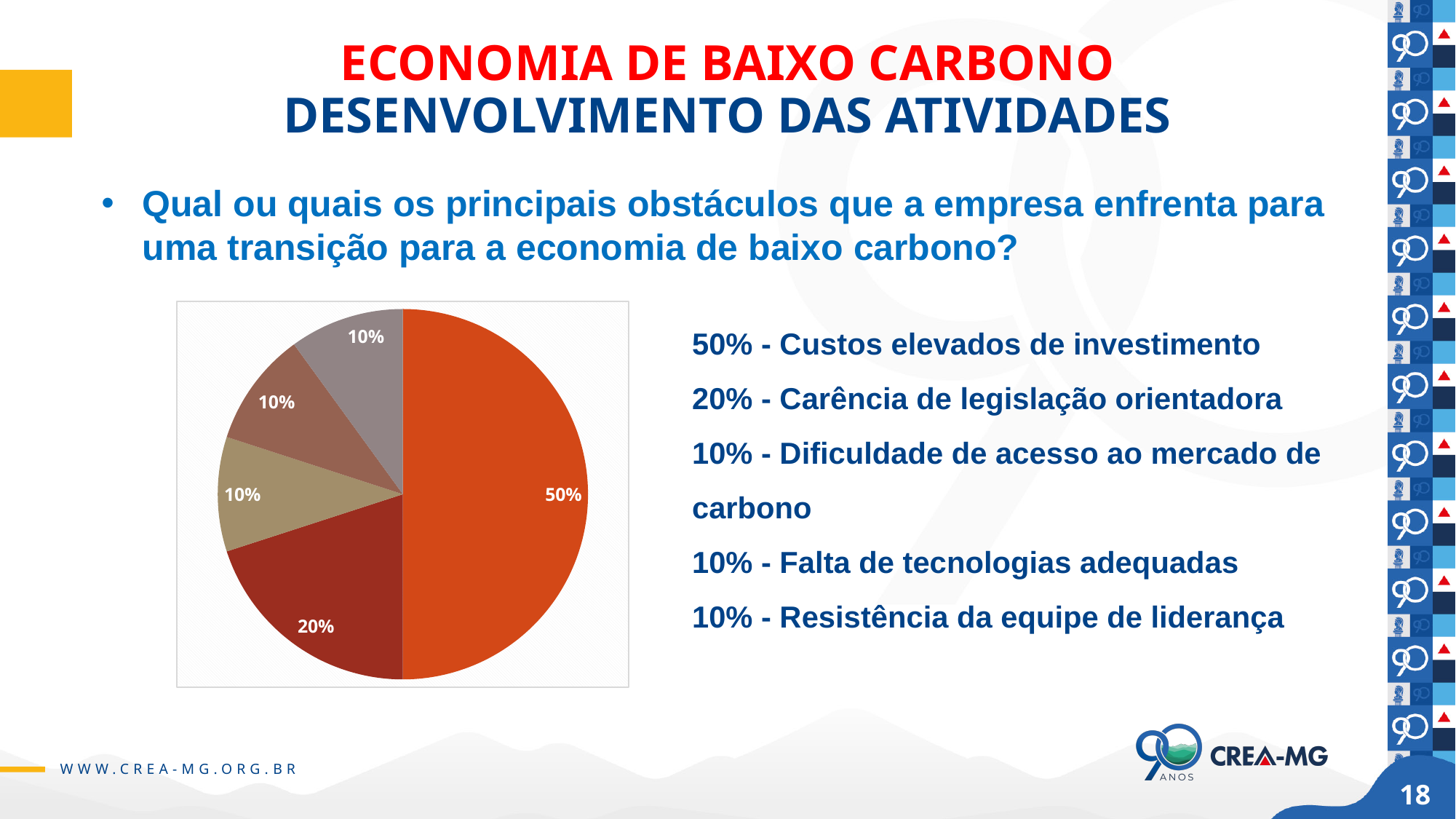
Which is larger: the share for 'Carência de legislação orientadora' or the share for 'Dificuldade de acesso ao mercado de carbono'? Carência de legislação orientadora What percentage is shown for 'Falta de tecnologias adequadas'? 10% How many slices of the pie chart are labelled 10%? 3 What percentage is shown for 'Resistência da equipe de liderança'? 10% What percentage is shown for 'Carência de legislação orientadora'? 20% What is the difference in percentage points between 'Custos elevados de investimento' and 'Carência de legislação orientadora'? 30 How many slices does the pie chart have? 5 What share of the pie does the largest slice represent? 50% What is the combined share of the three slices labelled 10%? 30% What kind of chart is shown on the slide? pie chart Which obstacle accounts for the largest share of the pie? Custos elevados de investimento What colour is the 50% slice of the pie chart? orange-red